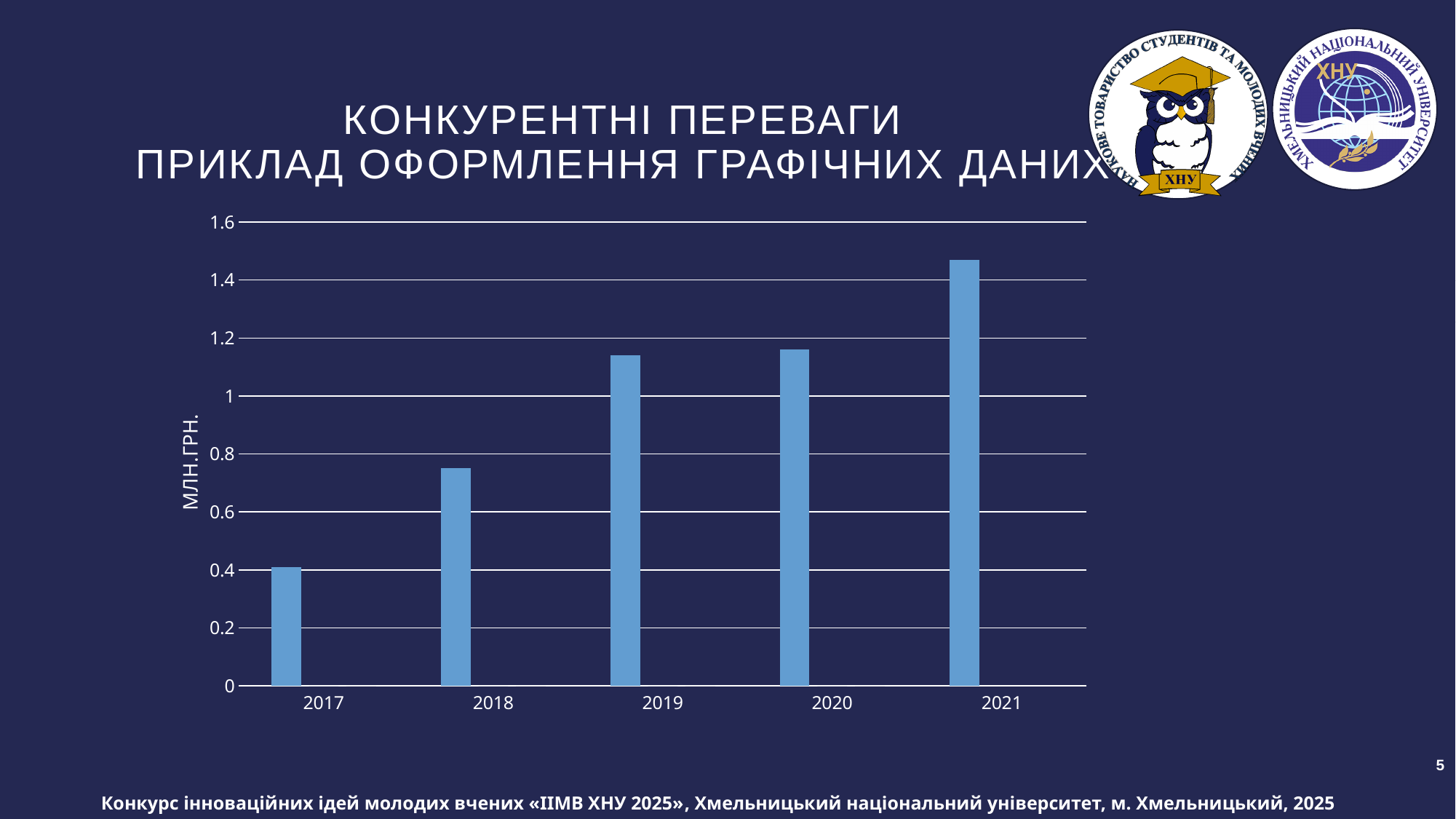
What kind of chart is shown on the slide? bar chart How many years are shown on the x axis of the chart? 5 What is the label on the vertical axis of the chart? МЛН.ГРН. Is the value for 2021 greater or less than 1.4? greater Do the values generally rise or fall from 2017 to 2021? rise Is the value for 2017 greater or less than 0.6? less Is the value for 2018 greater or less than 0.8? less Which year has the highest bar in the chart? 2021 Which is larger, the value for 2018 or the value for 2019? 2019 Which year has the lowest bar in the chart? 2017